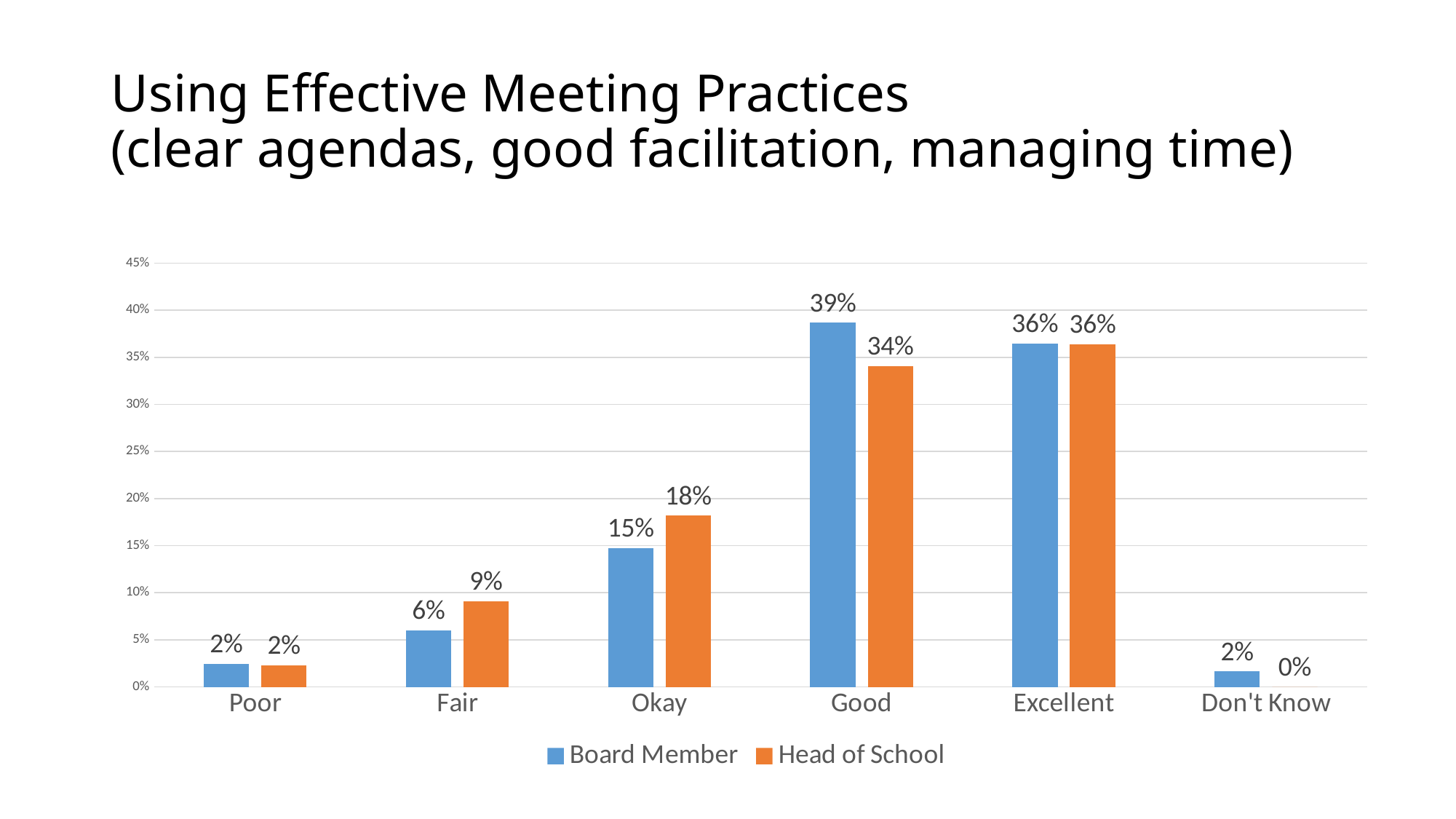
How many categories are shown on the x axis? 6 How many series does the legend list? 2 What is the difference between the Head of School and Board Member values for Fair? 3% What kind of chart is shown on the slide? Bar chart What colour are the Head of School bars? Orange What is the Head of School value for Okay? 18% What is the Head of School value for Don't Know? 0% What is the Board Member value for Good? 39% What is the difference between the Board Member and Head of School values for Good? 5% Which category has the lowest Head of School value? Don't Know For Okay, which series has the larger value, Board Member or Head of School? Head of School Which category has the highest Board Member value? Good